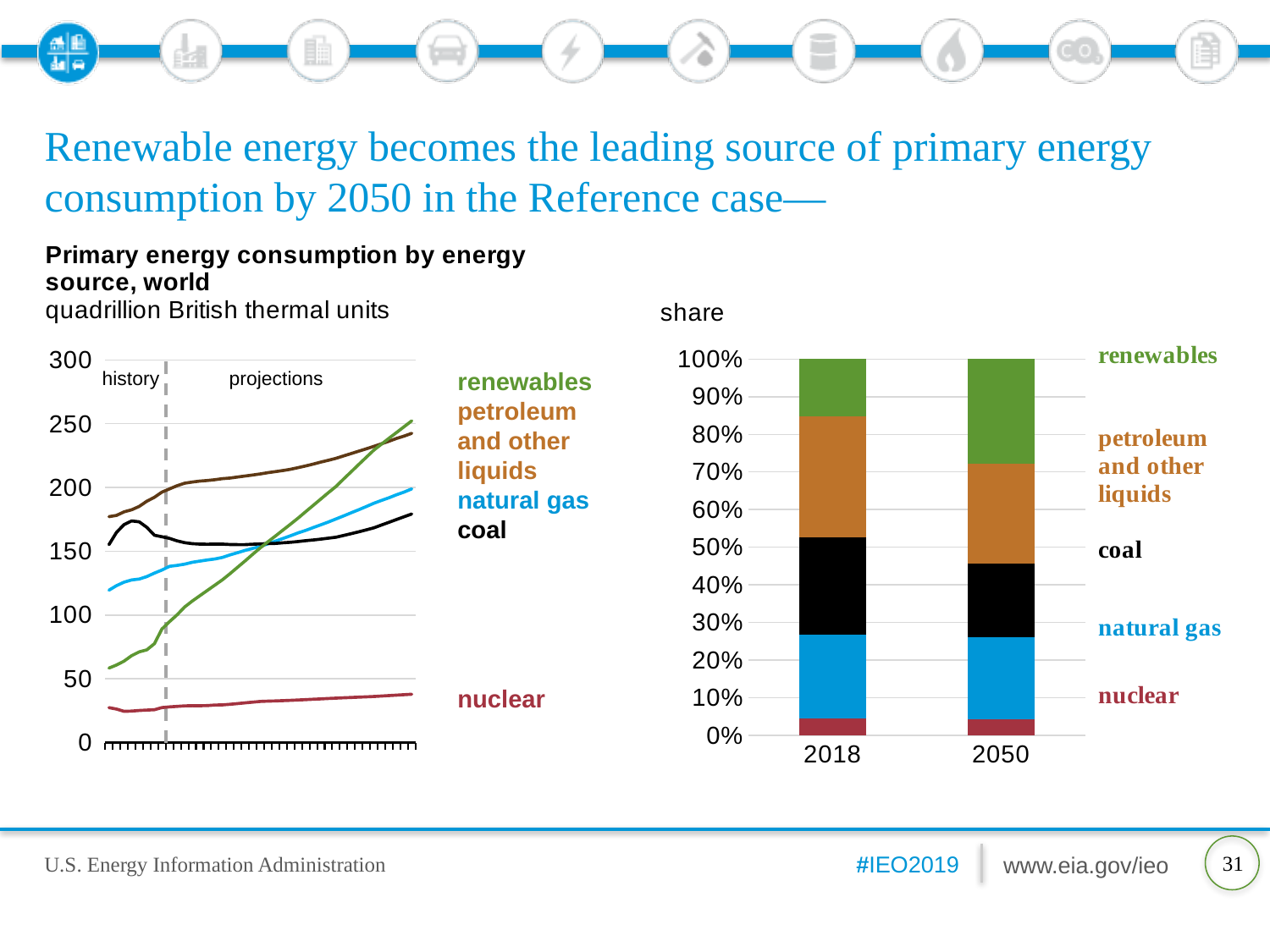
What kind of chart is the left chart, 'Primary energy consumption by energy source, world'? line chart In the right share chart, is the renewables share in 2050 greater or less than 20%? greater In the right share chart, how many years (bars) are shown? 2 What kind of chart is the right chart showing share? bar chart In the left chart, is the value for nuclear at the end of the projection period greater or less than 50? less In the left chart, how many energy source series are plotted? 5 In the left chart, at the end of the projection period, which is higher: renewables or coal? renewables In the right share chart, which energy source has the largest share in 2018? petroleum and other liquids In the left chart, is the value for renewables at the end of the projection period greater or less than 200? greater In the left chart, which energy source has the lowest consumption throughout the period? nuclear In the right share chart, is the renewables share larger in 2018 or in 2050? 2050 In the left chart, does the renewables line rise or fall across the projection period? rise